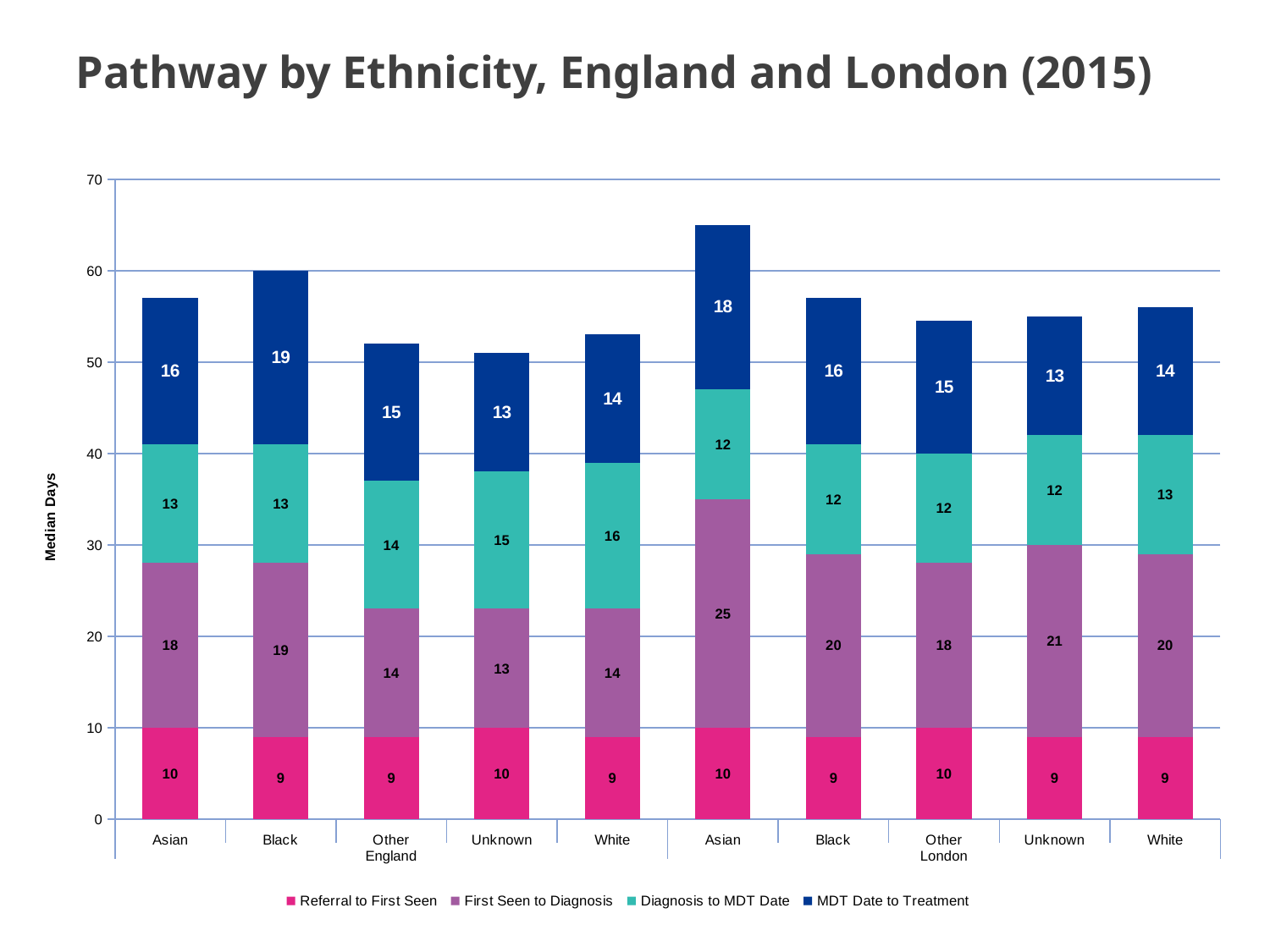
How many bars are plotted in the chart? 10 What is the difference in First Seen to Diagnosis median days between Asian in London and Asian in England? 7 What is the total median days for the Black bar in England? 60 What is the median days for Diagnosis to MDT Date for White in England? 16 What is the median days for MDT Date to Treatment for Black in England? 19 What is the title of the chart? Pathway by Ethnicity, England and London (2015) What is the median days for Referral to First Seen for Unknown in London? 9 How many series does the legend list? 4 What kind of chart is shown on the slide? Stacked bar chart Which is larger: MDT Date to Treatment for Asian in London or for Asian in England? Asian in London What is the median days for First Seen to Diagnosis for Asian in London? 25 Which bar has the highest total median days? Asian (London)